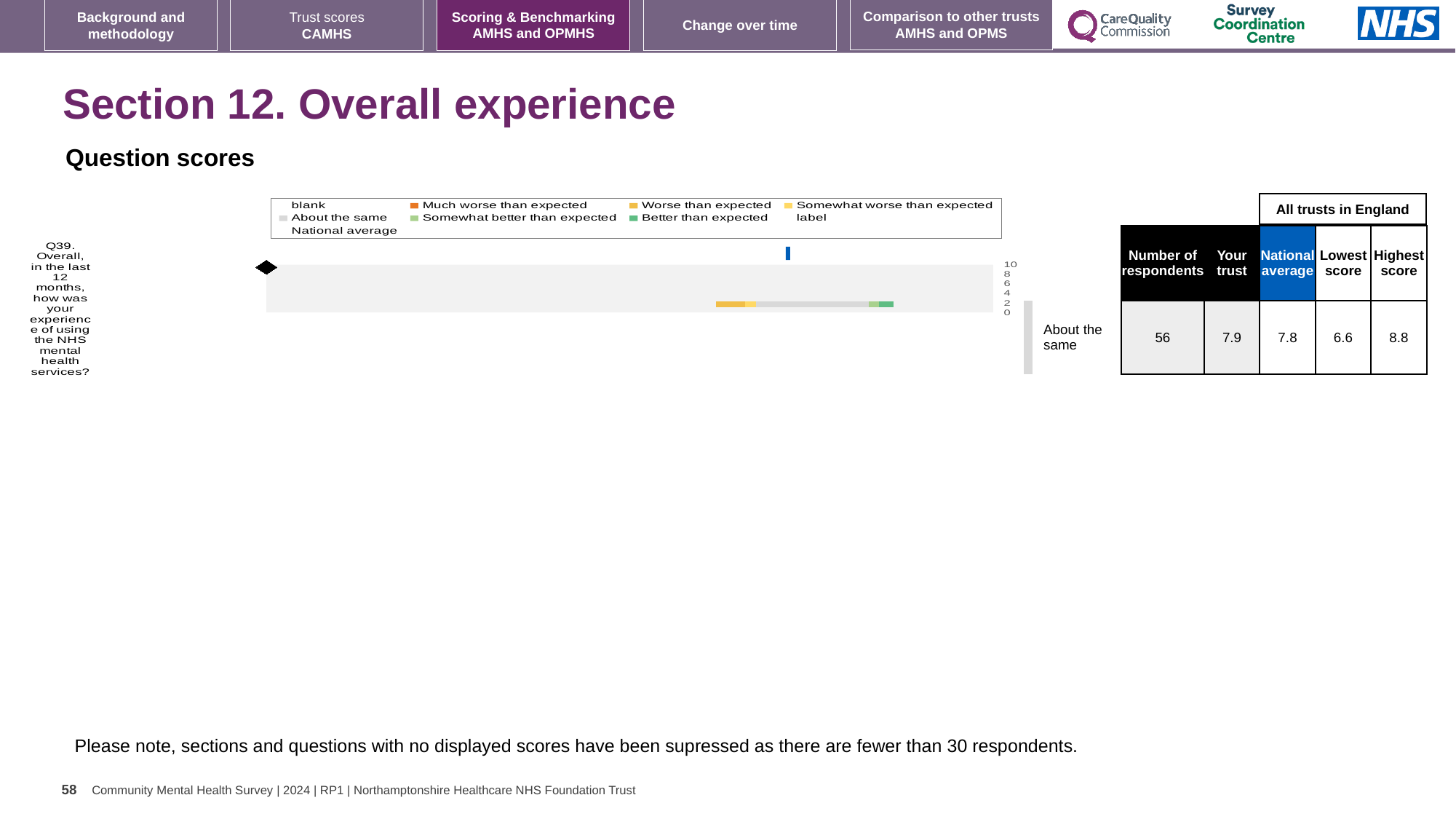
Which is larger for Q39, the 'Your trust' score or the national average? Your trust What is the 'Your trust' score for Q39 shown next to the chart? 7.9 What is the highest score among all trusts in England for Q39? 8.8 How many respondents answered Q39? 56 What is the lowest score among all trusts in England for Q39? 6.6 What is the highest value shown on the chart's axis? 10 What kind of chart is shown on the slide? bar chart Which benchmark category is the trust's Q39 score placed in? About the same Which question is plotted on the chart? Q39. Overall, in the last 12 months, how was your experience of using the NHS mental health services? What is the national average score for Q39 shown next to the chart? 7.8 What is the difference between the highest score and the lowest score for Q39? 2.2 How many survey questions are plotted on the chart? 1